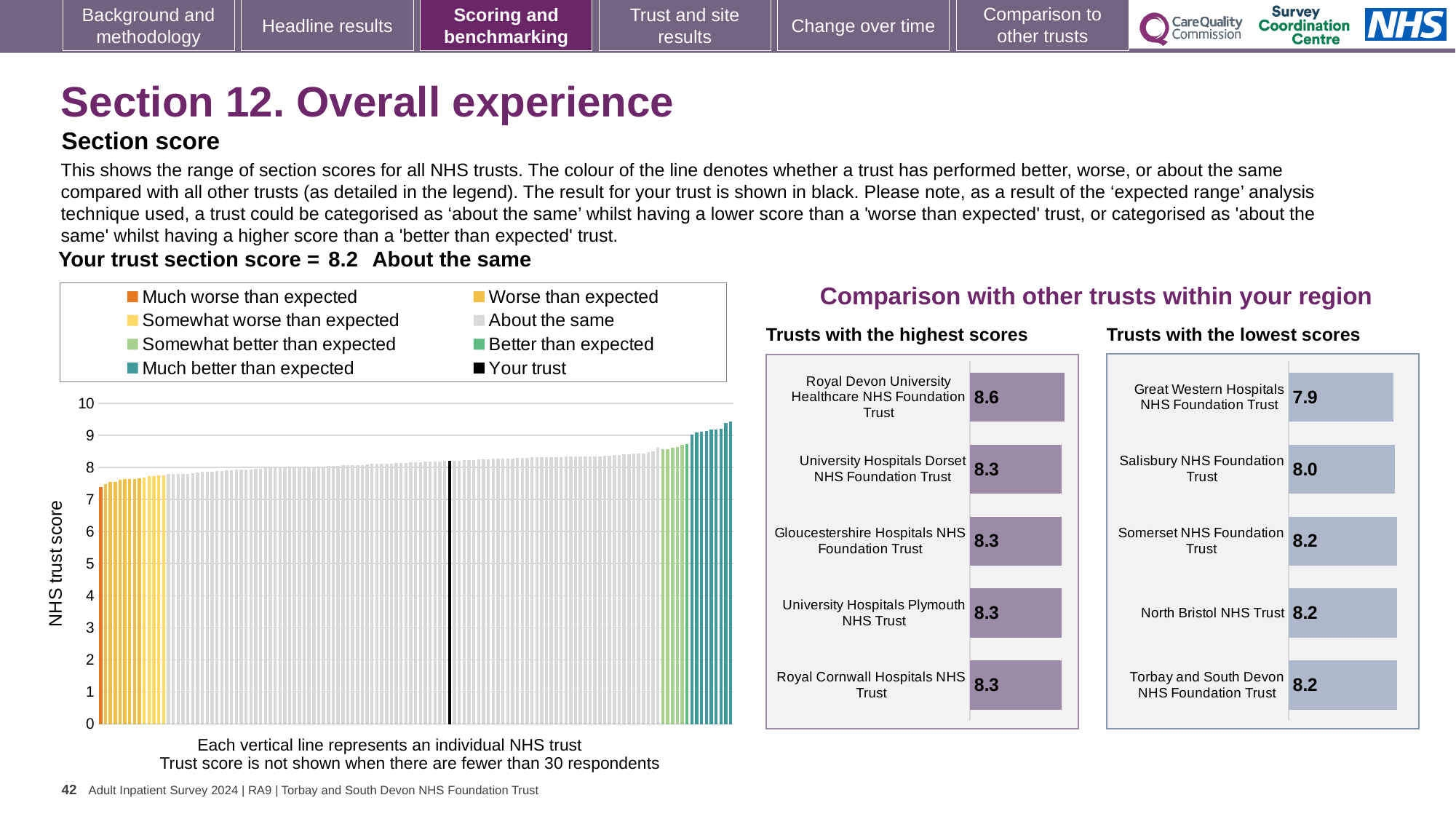
In the 'Trusts with the lowest scores' chart, which has the higher score: Great Western Hospitals NHS Foundation Trust or Somerset NHS Foundation Trust? Somerset NHS Foundation Trust How many trusts are shown in the 'Trusts with the lowest scores' chart? 5 In the 'Trusts with the lowest scores' chart, which trust has the lowest score? Great Western Hospitals NHS Foundation Trust How many trusts are shown in the 'Trusts with the highest scores' chart? 5 How many entries does the legend of the large 'NHS trust score' chart on the left list? 8 In the large 'NHS trust score' chart on the left, do the values rise or fall from left to right along the x axis? rise In the 'Trusts with the highest scores' chart, which trust has the highest score? Royal Devon University Healthcare NHS Foundation Trust In the 'Trusts with the highest scores' chart, what is the difference between the scores of Royal Devon University Healthcare NHS Foundation Trust and University Hospitals Dorset NHS Foundation Trust? 0.3 In the 'Trusts with the lowest scores' chart, what is the score for Salisbury NHS Foundation Trust? 8.0 In the 'Trusts with the lowest scores' chart, what is the score for Great Western Hospitals NHS Foundation Trust? 7.9 In the large 'NHS trust score' chart on the left, is the value of the tallest bar greater or less than 9? greater In the 'Trusts with the highest scores' chart, what is the score for Royal Devon University Healthcare NHS Foundation Trust? 8.6